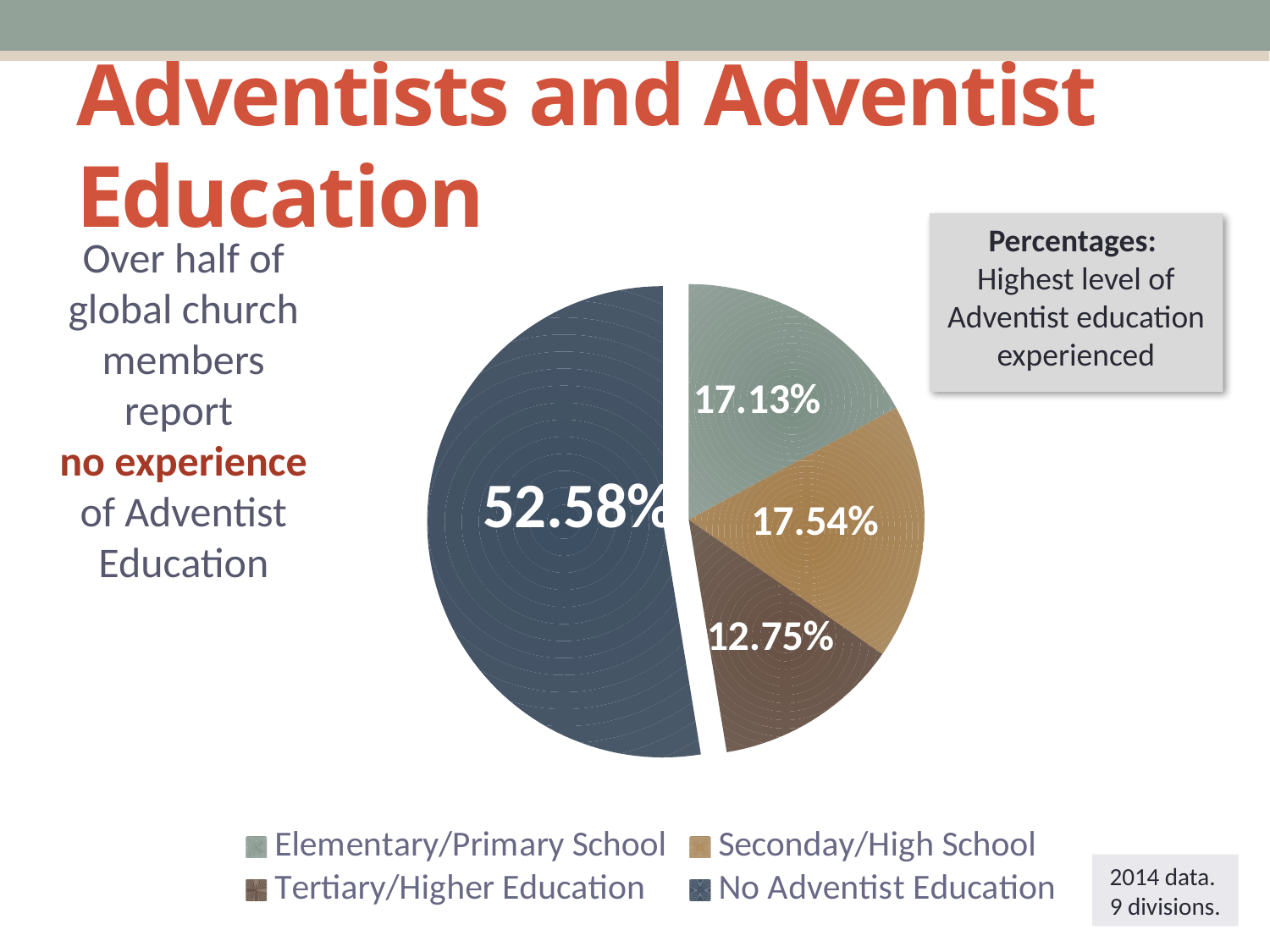
What kind of chart is shown on the slide? Pie chart Which is larger, the Seconday/High School slice or the Tertiary/Higher Education slice? Seconday/High School What percentage is shown for Tertiary/Higher Education? 12.75% What percentage of the pie is labelled for No Adventist Education? 52.58% What percentage is shown for Elementary/Primary School? 17.13% What percentage is shown for Seconday/High School? 17.54% Which category has the largest slice of the pie? No Adventist Education What is the difference between the No Adventist Education slice and the Tertiary/Higher Education slice? 39.83% What is the combined percentage of the Elementary/Primary School and Seconday/High School slices? 34.67% How many slices does the pie chart have? 4 Which slice of the pie is separated (exploded) from the others? No Adventist Education Which category has the smallest slice of the pie? Tertiary/Higher Education